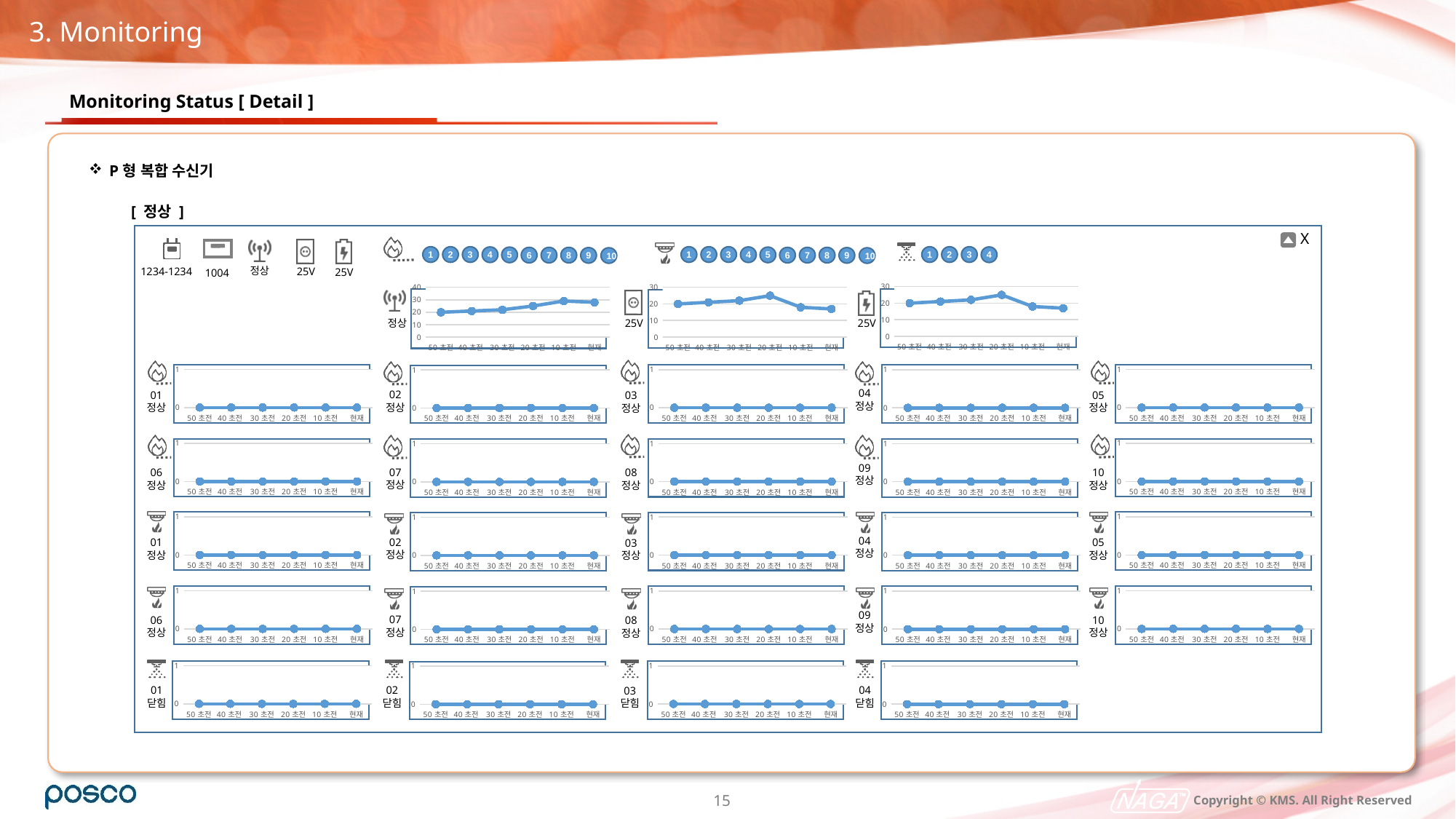
On the top-left line chart (next to the 정상 signal icon), do the values rise or fall from 50 초전 to 현재? rise On the top-left line chart (next to the 정상 signal icon), is the value at 50 초전 greater or less than 30? less On the top-middle line chart (next to the 25V plug icon), which x-axis point has the highest value? 20 초전 What is the highest y-axis tick shown on the top-left line chart (next to the 정상 signal icon)? 40 On the top-left line chart (next to the 정상 signal icon), is the value at 현재 greater or less than 20? greater What is the last x-axis label on the top-left line chart (next to the 정상 signal icon)? 현재 On the top-right line chart (next to the 25V battery icon), which x-axis point has the highest value? 20 초전 What is the value at 현재 on the small chart labelled 01 정상 in the first row of small charts? 0 On the top-right line chart (next to the 25V battery icon), is the value at 현재 greater or less than 20? less How many data points are plotted on the top-left line chart (next to the 정상 signal icon)? 6 What kind of chart is the top-left chart next to the signal icon labelled 정상? line chart On the top-middle line chart (next to the 25V plug icon), which is larger: the value at 20 초전 or the value at 현재? 20 초전